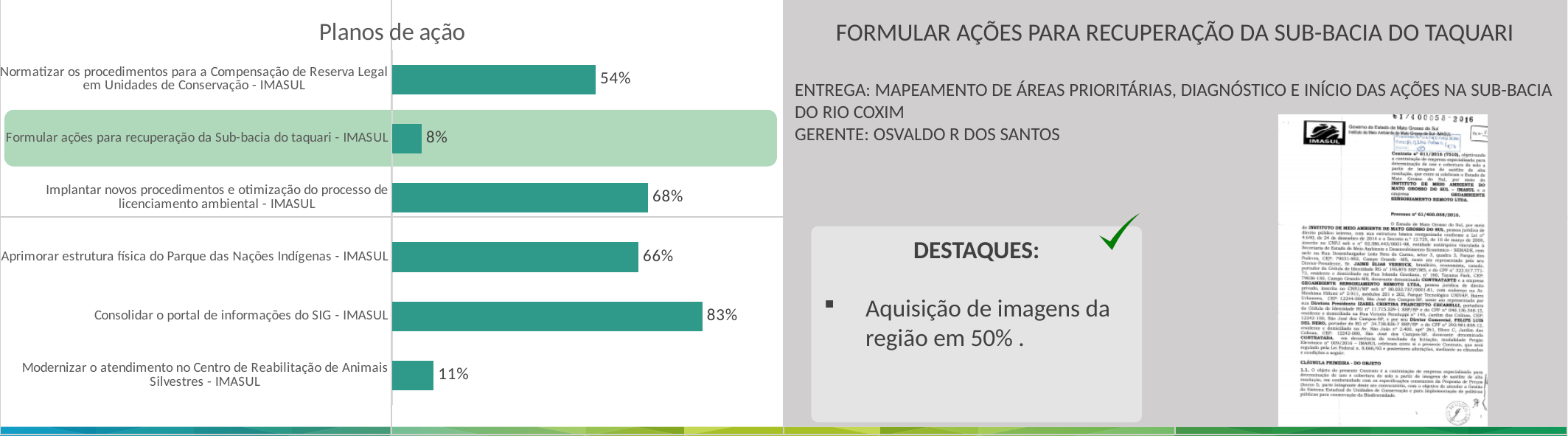
What kind of chart is shown on the slide? Bar chart What is the value for "Consolidar o portal de informações do SIG - IMASUL"? 83% Which is larger: the value for "Implantar novos procedimentos e otimização do processo de licenciamento ambiental - IMASUL" or for "Aprimorar estrutura física do Parque das Nações Indígenas - IMASUL"? Implantar novos procedimentos e otimização do processo de licenciamento ambiental - IMASUL What is the value for "Modernizar o atendimento no Centro de Reabilitação de Animais Silvestres - IMASUL"? 11% What is the title of the chart? Planos de ação What is the difference between the values for "Modernizar o atendimento no Centro de Reabilitação de Animais Silvestres - IMASUL" and "Formular ações para recuperação da Sub-bacia do taquari - IMASUL"? 3% What is the difference between the values for "Consolidar o portal de informações do SIG - IMASUL" and "Normatizar os procedimentos para a Compensação de Reserva Legal em Unidades de Conservação - IMASUL"? 29% What is the value for "Formular ações para recuperação da Sub-bacia do taquari - IMASUL"? 8% Which category has the lowest value? Formular ações para recuperação da Sub-bacia do taquari - IMASUL Which category has the highest value? Consolidar o portal de informações do SIG - IMASUL Which category's bar is highlighted with a green background in the chart? Formular ações para recuperação da Sub-bacia do taquari - IMASUL How many categories are shown in the chart? 6